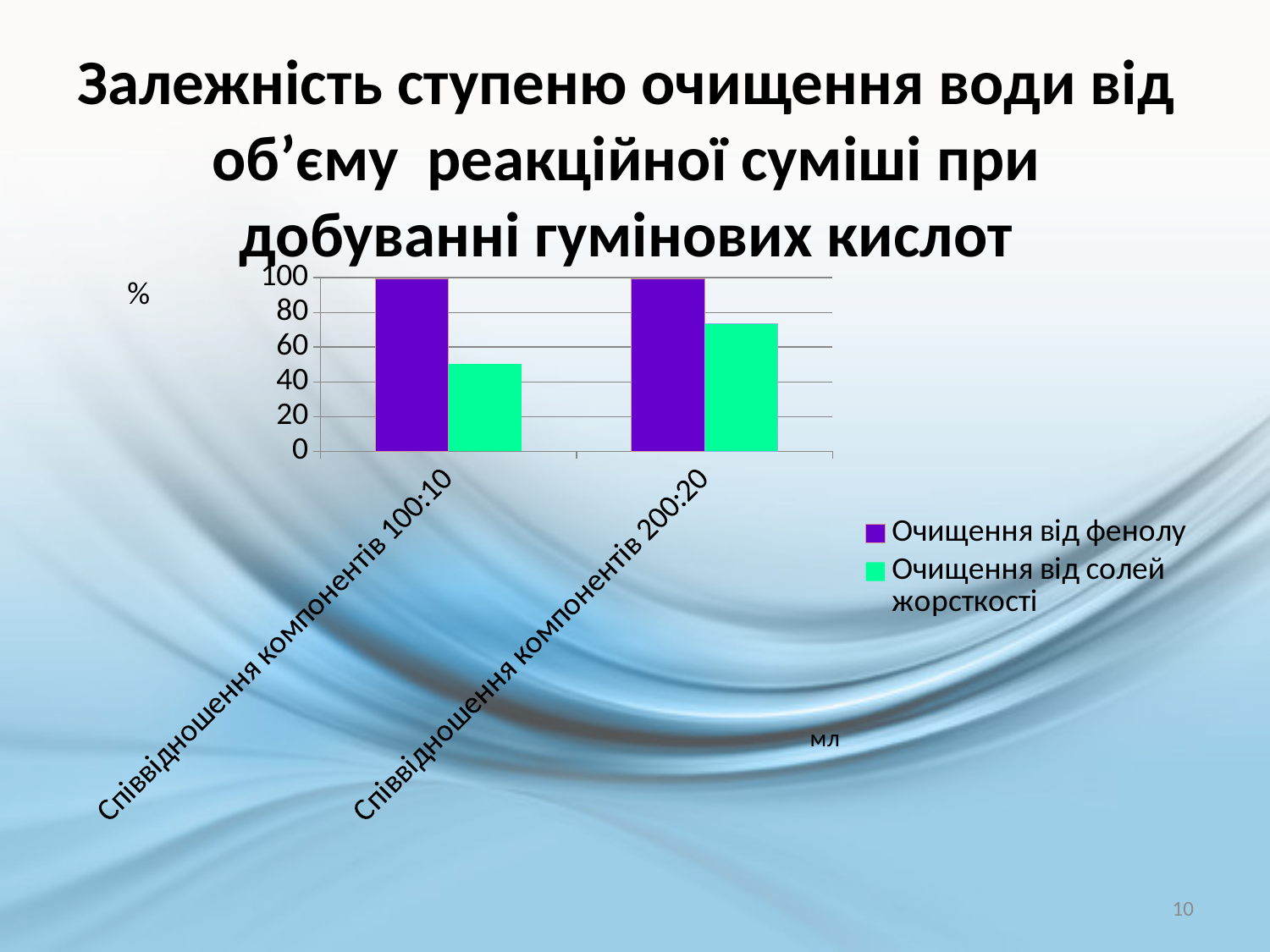
Does the "Очищення від солей жорсткості" series rise or fall from "Співвідношення компонентів 100:10" to "Співвідношення компонентів 200:20"? rise Is the value of "Очищення від солей жорсткості" for "Співвідношення компонентів 100:10" greater or less than 60? less Is the value of "Очищення від солей жорсткості" for "Співвідношення компонентів 200:20" greater or less than 80? less What colour are the bars for the "Очищення від фенолу" series? purple How many categories are shown on the x axis? 2 What kind of chart is shown on the slide? bar chart Is the value of "Очищення від солей жорсткості" for "Співвідношення компонентів 200:20" greater or less than 60? greater For "Очищення від солей жорсткості", which category has the larger value: "Співвідношення компонентів 100:10" or "Співвідношення компонентів 200:20"? Співвідношення компонентів 200:20 How many series does the legend list? 2 For "Співвідношення компонентів 200:20", which series has the larger value: "Очищення від фенолу" or "Очищення від солей жорсткості"? Очищення від фенолу